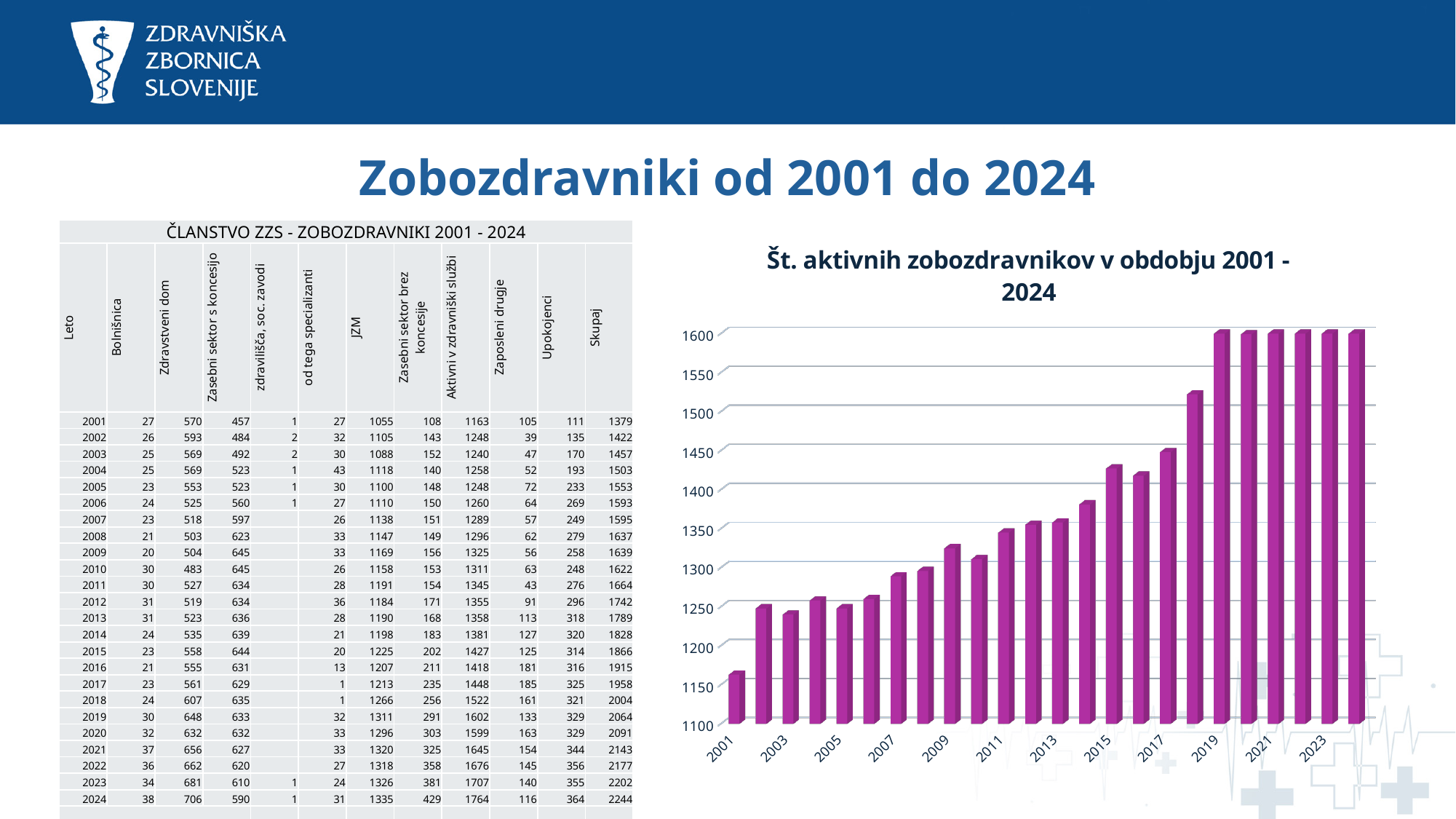
In the chart 'Št. aktivnih zobozdravnikov v obdobju 2001 - 2024', which year has the higher bar, 2016 or 2017? 2017 What is the title of the chart on the right side of the slide? Št. aktivnih zobozdravnikov v obdobju 2001 - 2024 In the chart 'Št. aktivnih zobozdravnikov v obdobju 2001 - 2024', do the values generally rise or fall from 2001 to 2024? rise What kind of chart is shown on the right side of the slide? bar chart In the chart 'Št. aktivnih zobozdravnikov v obdobju 2001 - 2024', which year has the lowest bar? 2001 In the chart 'Št. aktivnih zobozdravnikov v obdobju 2001 - 2024', is the value for 2001 greater or less than 1200? less In the chart 'Št. aktivnih zobozdravnikov v obdobju 2001 - 2024', is the value for 2009 greater or less than 1300? greater How many bars (years) are plotted in the chart 'Št. aktivnih zobozdravnikov v obdobju 2001 - 2024'? 24 In the chart 'Št. aktivnih zobozdravnikov v obdobju 2001 - 2024', which year has the higher bar, 2008 or 2009? 2009 What colour are the bars in the chart 'Št. aktivnih zobozdravnikov v obdobju 2001 - 2024'? purple (magenta) In the chart 'Št. aktivnih zobozdravnikov v obdobju 2001 - 2024', is the value for 2014 greater or less than 1400? less